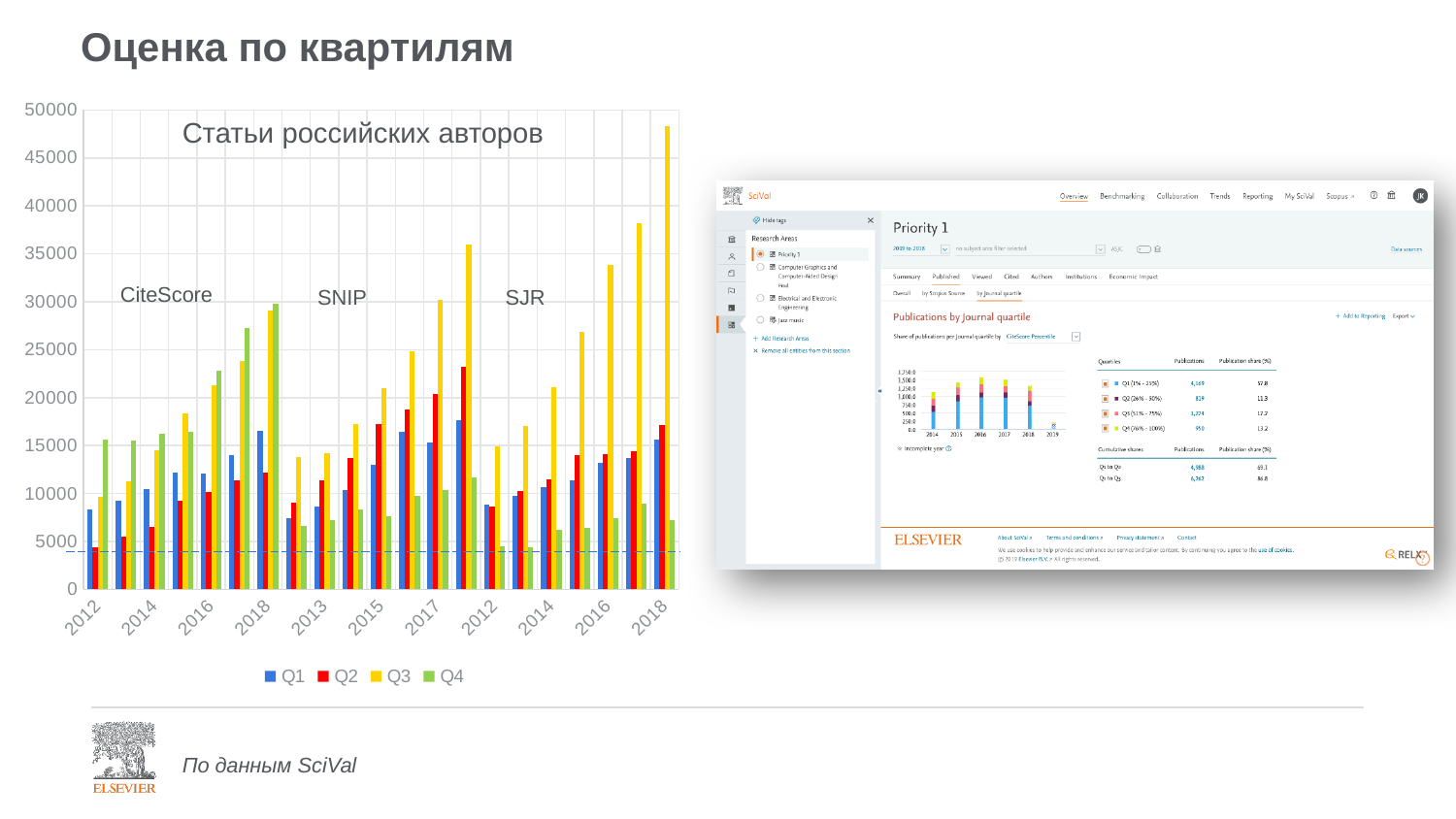
What kind of chart is shown on the slide? bar chart Is the Q2 value for 2012 in the CiteScore section greater or less than 5000? less How many series does the legend of the chart list? 4 Does the Q3 series in the SJR section rise or fall overall from 2012 to 2018? rise Which series has the tallest bar anywhere in the chart? Q3 Is the Q3 value for 2018 in the SNIP section greater or less than 35000? greater Is the Q3 value for 2017 in the SJR section greater or less than 25000? greater In which section and year does the tallest bar of the chart appear? SJR, 2018 In the SJR section for 2018, which is larger, Q3 or Q1? Q3 What are the series names in the chart legend? Q1, Q2, Q3, Q4 What is the title of the bar chart? Статьи российских авторов